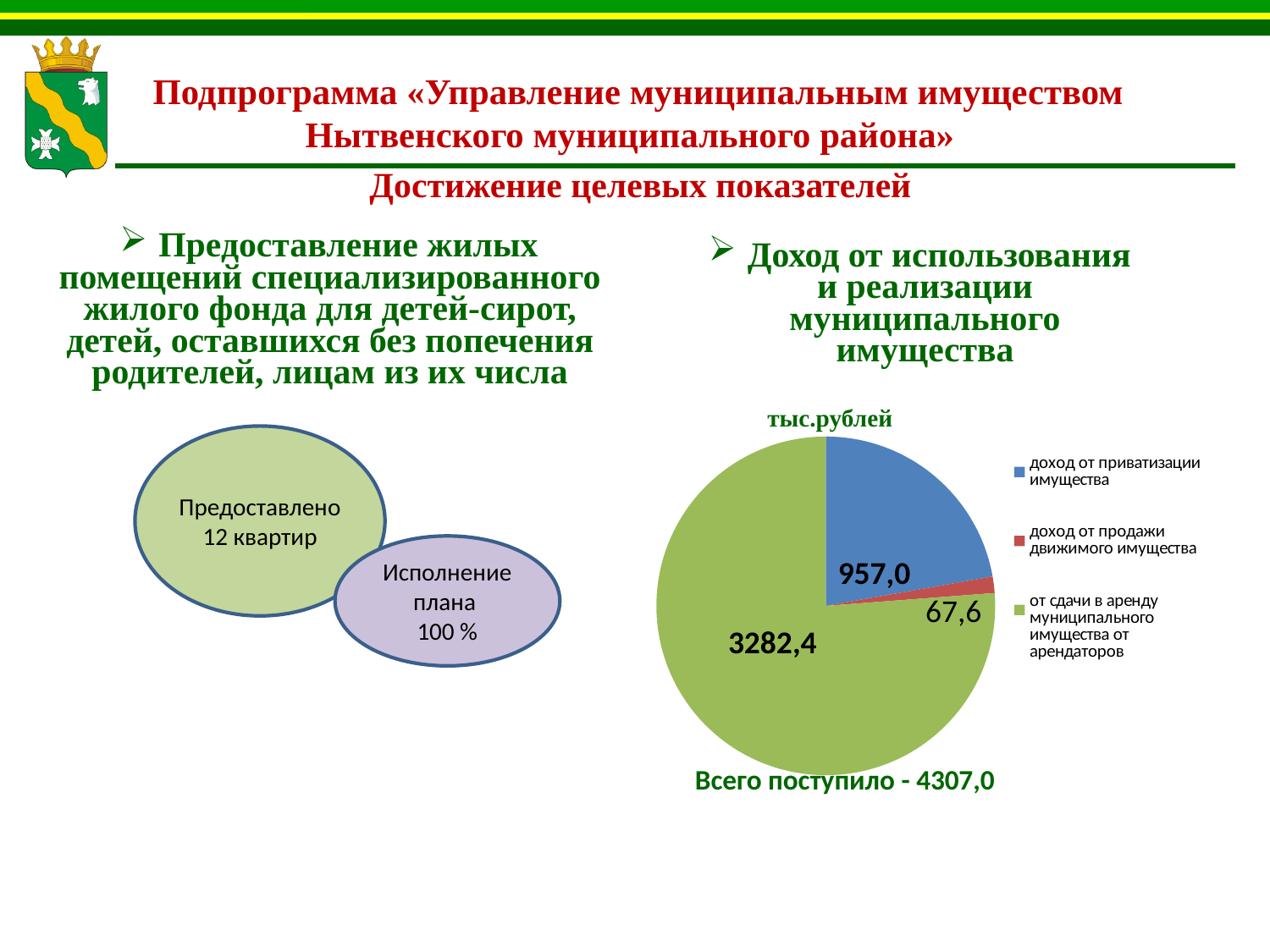
Which is larger in the pie chart: «доход от приватизации имущества» or «доход от продажи движимого имущества»? доход от приватизации имущества What is the value for «доход от приватизации имущества» in the pie chart? 957,0 What is the difference between the value for «от сдачи в аренду муниципального имущества от арендаторов» and the value for «доход от приватизации имущества»? 2325,4 What is the value for «доход от продажи движимого имущества» in the pie chart? 67,6 What unit is given above the pie chart? тыс.рублей What total amount is stated below the pie chart («Всего поступило»)? 4307,0 What is the difference between the value for «доход от приватизации имущества» and the value for «доход от продажи движимого имущества»? 889,4 How many slices does the pie chart have? 3 What is the value for «от сдачи в аренду муниципального имущества от арендаторов» in the pie chart? 3282,4 Which category has the largest slice in the pie chart? от сдачи в аренду муниципального имущества от арендаторов Which category has the smallest slice in the pie chart? доход от продажи движимого имущества What kind of chart is shown under the heading «Доход от использования и реализации муниципального имущества»? pie chart